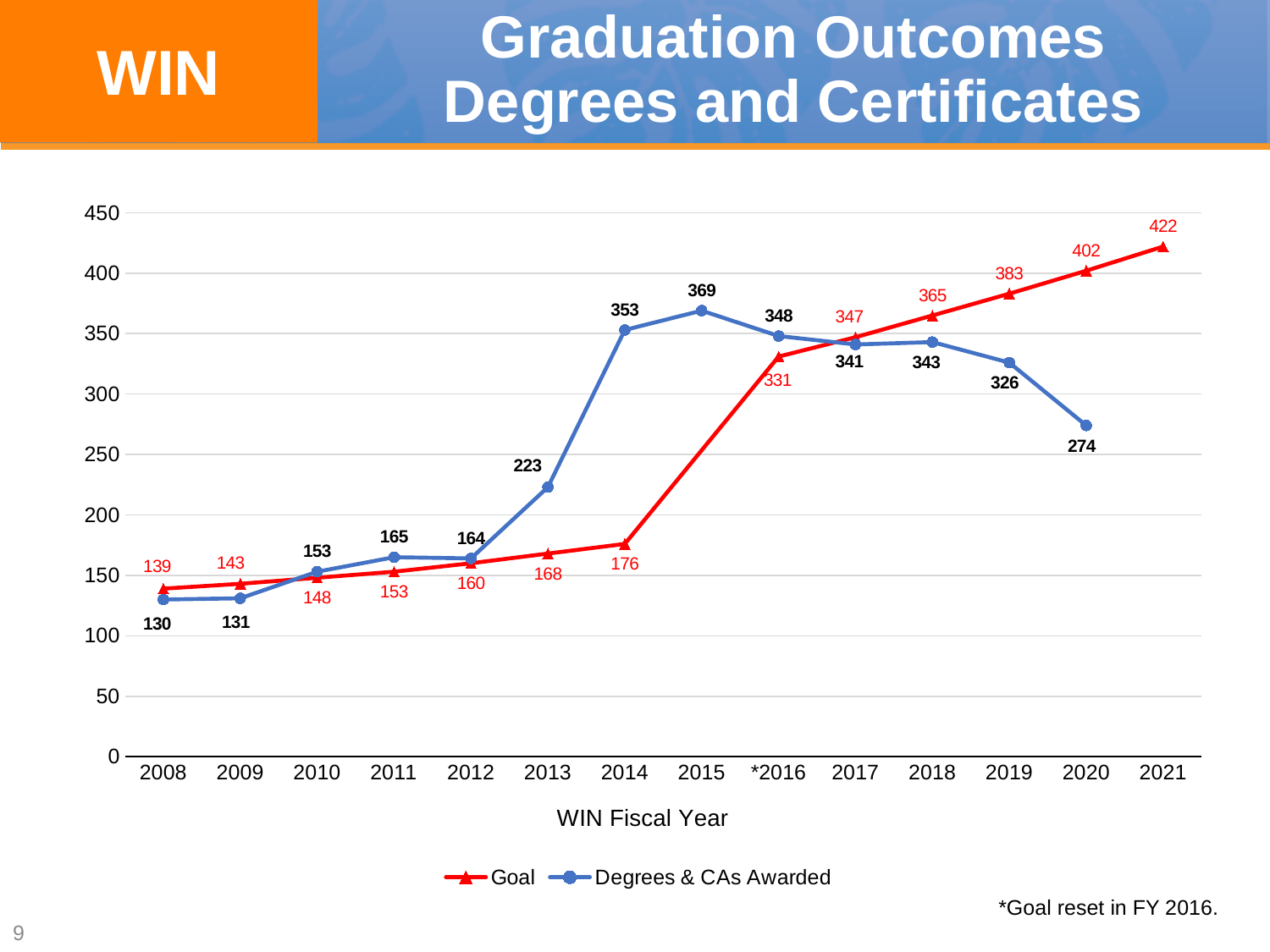
What is the value of Degrees & CAs Awarded in 2020? 274 Which is larger in 2013, the Goal or Degrees & CAs Awarded? Degrees & CAs Awarded In which year is Degrees & CAs Awarded lowest? 2008 What is the Goal value for 2013? 168 What is the Goal value for 2021? 422 In which year is Degrees & CAs Awarded highest? 2015 What is the difference between Degrees & CAs Awarded and the Goal in 2014? 177 Which is larger in 2019, the Goal or Degrees & CAs Awarded? Goal How many series does the legend list? 2 How many fiscal years are shown on the x axis? 14 What is the value of Degrees & CAs Awarded in 2015? 369 What kind of chart is shown on the slide? Line chart